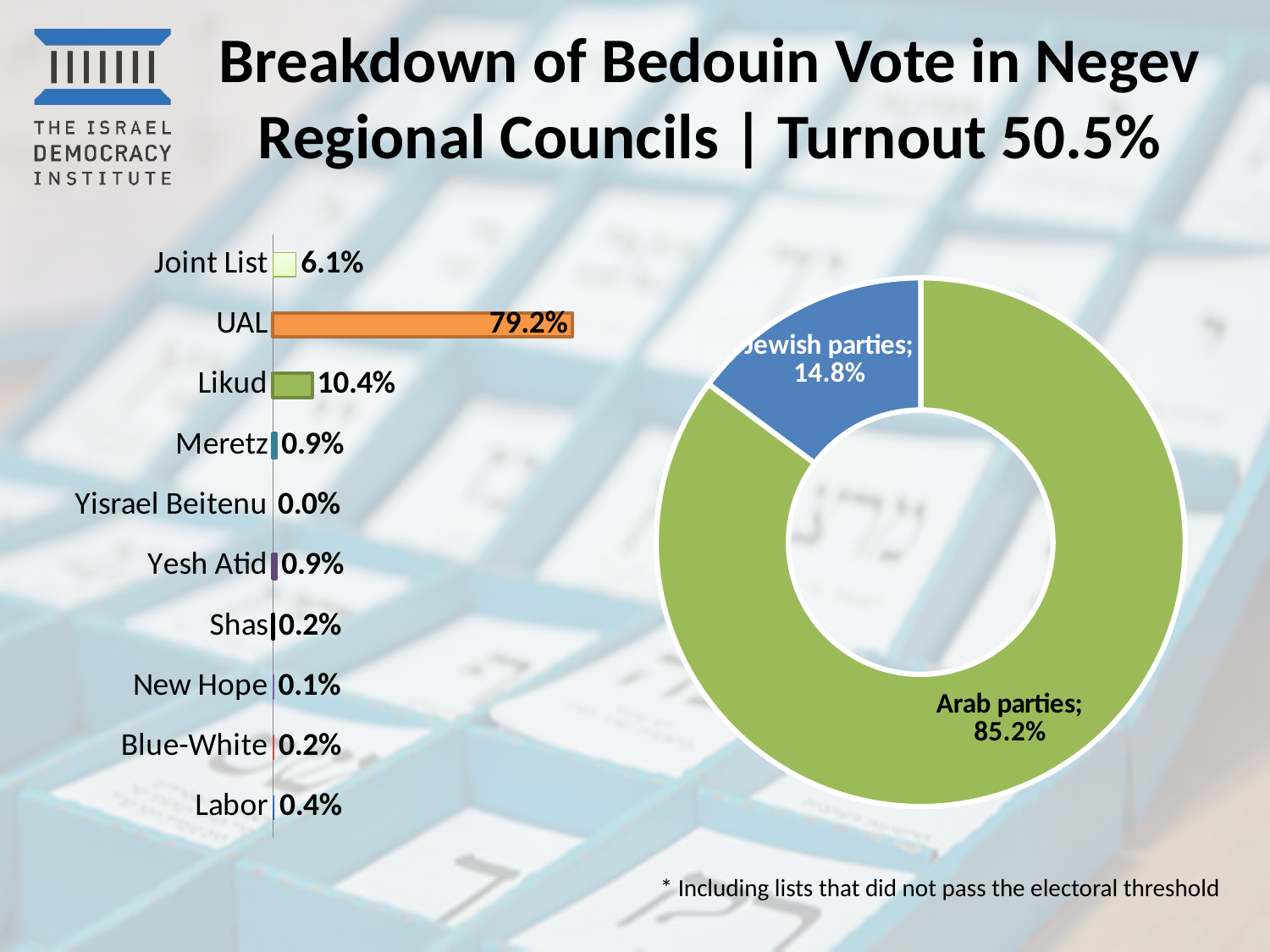
In the bar chart on the left, which party has the lowest share of the vote? Yisrael Beitenu In the donut chart on the right, what share is shown for Jewish parties? 14.8% In the bar chart on the left, what is the value shown for Yisrael Beitenu? 0.0% In the bar chart on the left, what share of the vote did Likud receive? 10.4% What type of chart is the chart on the left of the slide? Bar chart In the bar chart on the left, what share of the vote did UAL receive? 79.2% In the bar chart on the left, what is the difference between the shares for UAL and Likud? 68.8% How many parties are listed in the bar chart on the left? 10 In the bar chart on the left, which party has the highest share of the vote? UAL How many slices does the donut chart on the right have? 2 In the bar chart on the left, which has a larger share, Joint List or Likud? Likud In the donut chart on the right, what share is shown for Arab parties? 85.2%